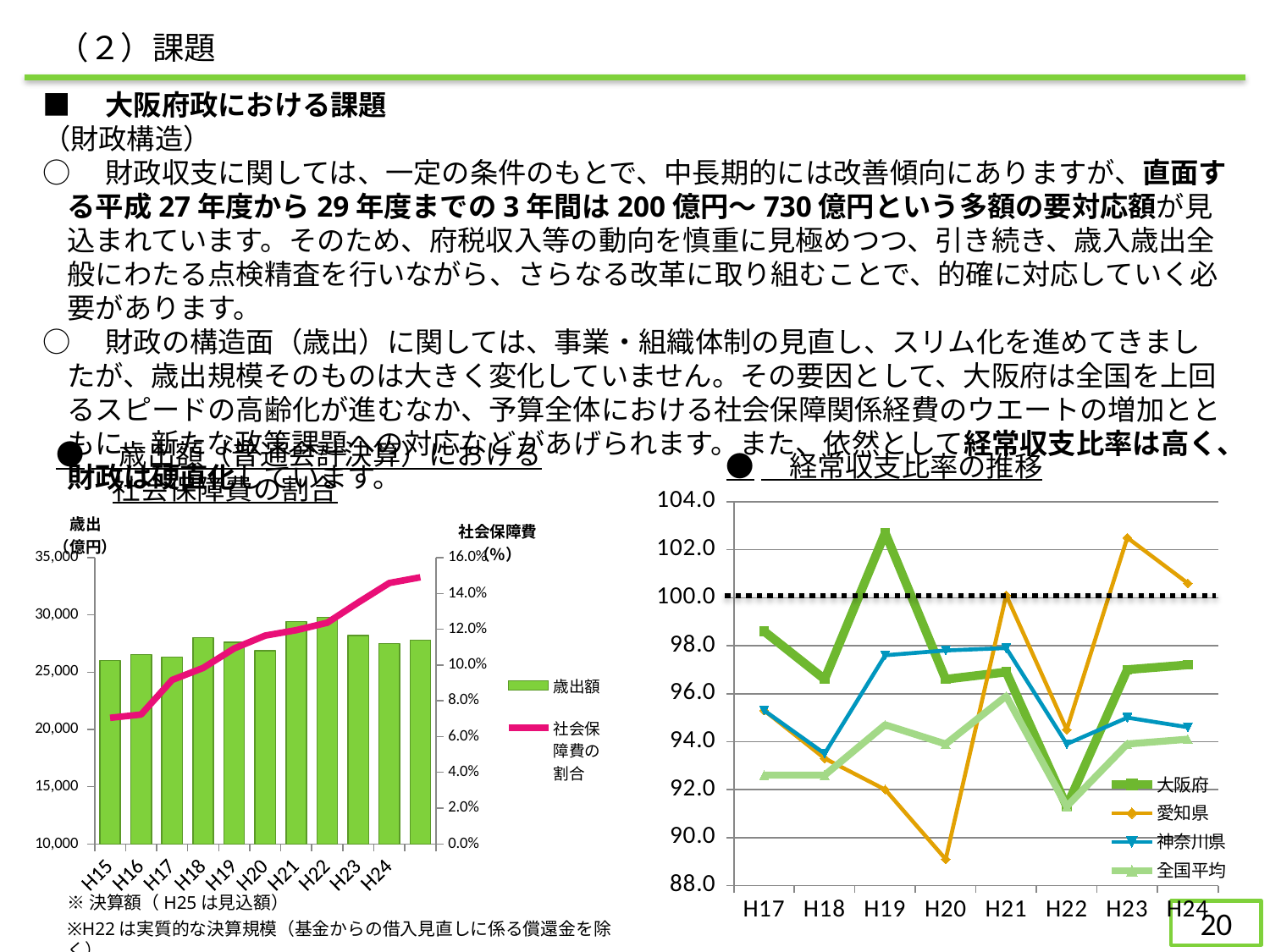
In the 経常収支比率の推移 chart, in which year does 大阪府 reach its highest value? H19 What kind of chart is the 経常収支比率の推移 chart on the right? line chart In the left chart, is the 歳出額 bar for H21 greater or less than 25,000? greater In the 経常収支比率の推移 chart, which is larger in H23, 愛知県 or 大阪府? 愛知県 In the 経常収支比率の推移 chart, is the value for 大阪府 in H19 greater or less than 102.0? greater In the left chart, is the 社会保障費の割合 value for H24 greater or less than 14.0%? greater How many fiscal years are shown on the x axis of the 経常収支比率の推移 chart? 8 In the 経常収支比率の推移 chart, in which year does 愛知県 reach its lowest value? H20 In the 経常収支比率の推移 chart, which is larger in H20, 大阪府 or 愛知県? 大阪府 In the left chart, does the 社会保障費の割合 line rise or fall from H15 to H24? rise How many series does the legend of the 経常収支比率の推移 chart list? 4